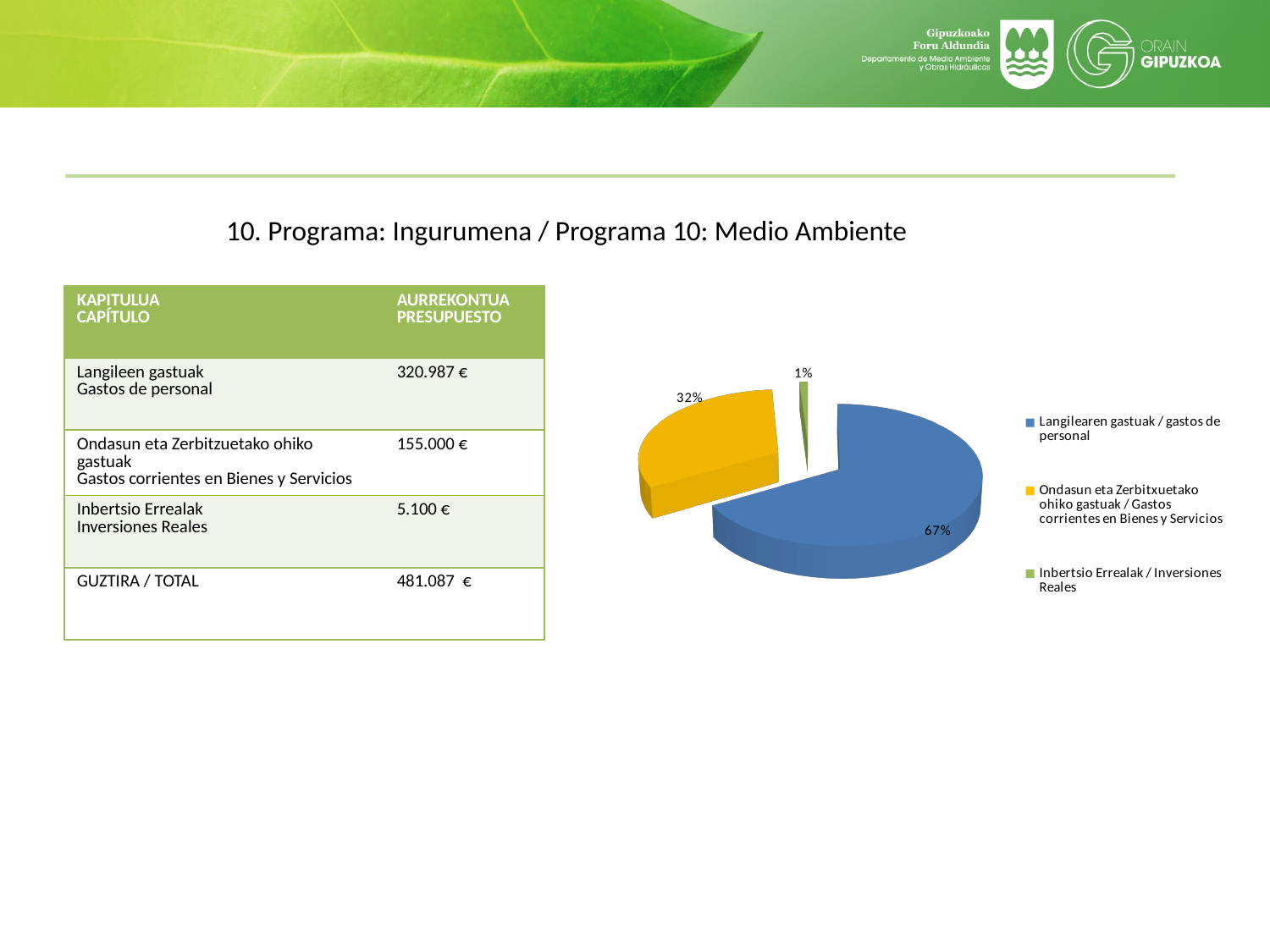
What colour is the slice for Langilearen gastuak / gastos de personal in the pie chart? blue What share of the pie does the slice for Langilearen gastuak / gastos de personal represent? 67% What share of the pie does the slice for Inbertsio Errealak / Inversiones Reales represent? 1% Which slice is larger: Ondasun eta Zerbitxuetako ohiko gastuak / Gastos corrientes en Bienes y Servicios or Inbertsio Errealak / Inversiones Reales? Ondasun eta Zerbitxuetako ohiko gastuak / Gastos corrientes en Bienes y Servicios What kind of chart is shown on the slide? pie chart How many slices does the pie chart have? 3 How many entries does the legend of the pie chart list? 3 What share of the pie does the slice for Ondasun eta Zerbitxuetako ohiko gastuak / Gastos corrientes en Bienes y Servicios represent? 32% Which category has the largest slice in the pie chart? Langilearen gastuak / gastos de personal What is the difference in percentage points between the slice for Langilearen gastuak / gastos de personal and the slice for Ondasun eta Zerbitxuetako ohiko gastuak / Gastos corrientes en Bienes y Servicios? 35 What colour is the slice for Ondasun eta Zerbitxuetako ohiko gastuak / Gastos corrientes en Bienes y Servicios in the pie chart? yellow Which category has the smallest slice in the pie chart? Inbertsio Errealak / Inversiones Reales